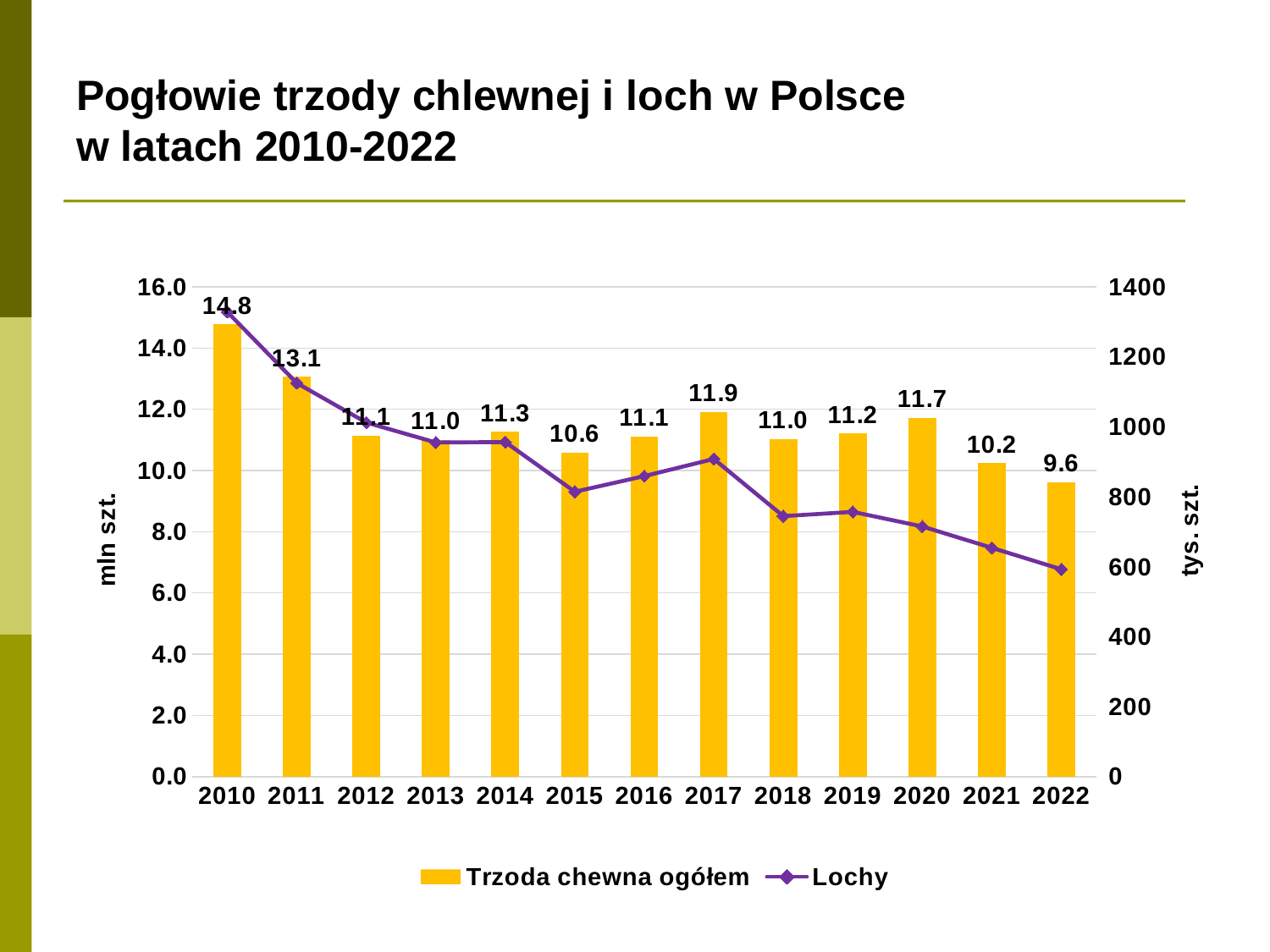
Is the Lochy value for 2022 greater or less than 800? less In which year is the Trzoda chlewna ogółem bar highest? 2010 Which year has the larger Trzoda chlewna ogółem value, 2017 or 2020? 2017 What is the value of Trzoda chlewna ogółem for 2010? 14.8 What is the difference between the Trzoda chlewna ogółem values for 2010 and 2022? 5.2 Does the Lochy line generally rise or fall from 2010 to 2022? fall What kind of chart is shown on the slide? Combined bar and line chart Is the Lochy value for 2010 greater or less than 1200? greater What is the value of Trzoda chlewna ogółem for 2022? 9.6 How many series does the legend list? 2 How many years are shown on the x axis? 13 In which year is the Trzoda chlewna ogółem bar lowest? 2022